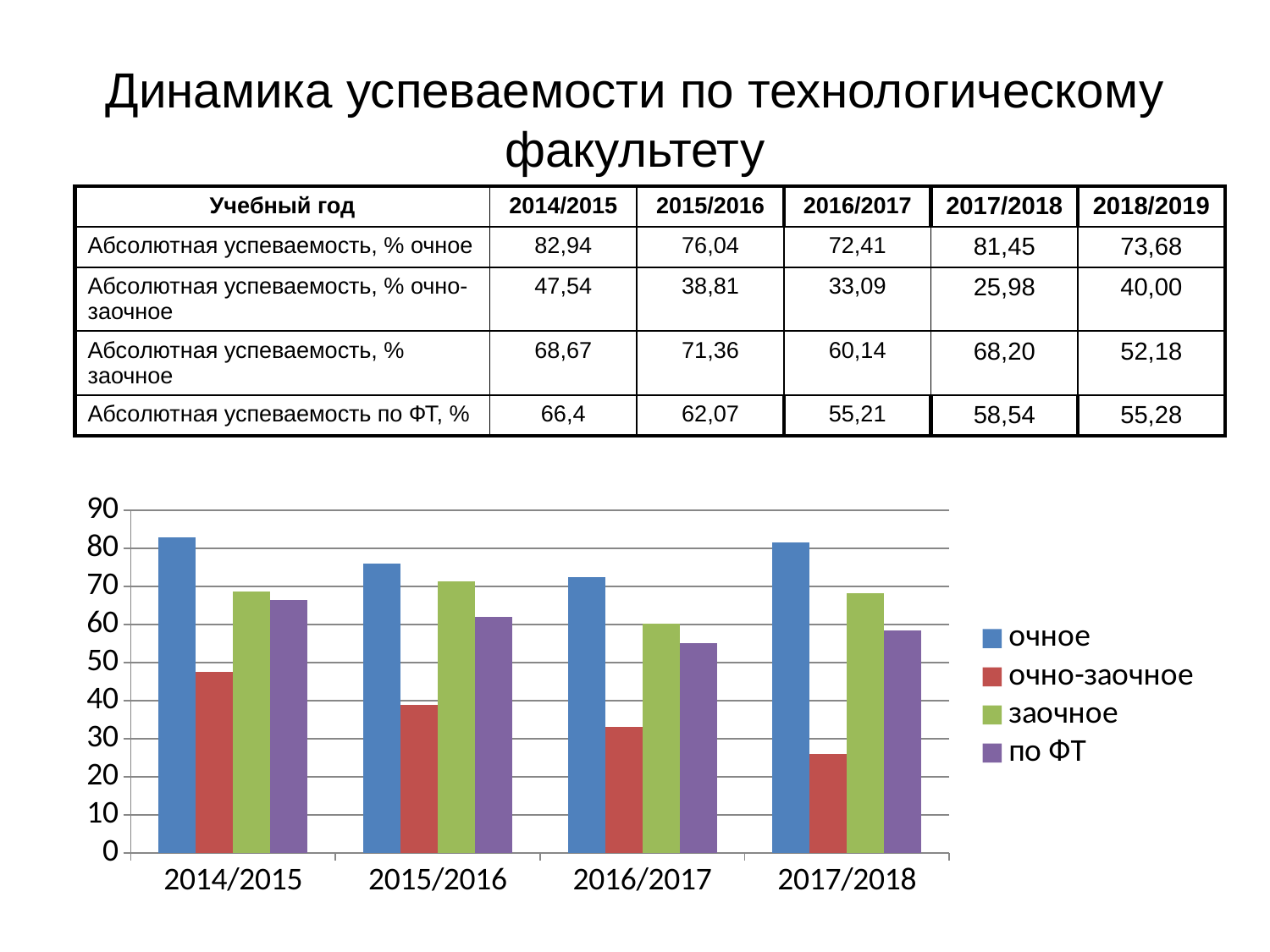
How many academic years are shown on the x axis of the chart? 4 How many series does the chart legend list? 4 According to the table, what is the difference between очное and очно-заочное in 2014/2015? 35,40 Is the value for очно-заочное in 2017/2018 greater or less than 30? less In 2015/2016, which is larger: заочное or по ФТ? заочное What colour represents the заочное series in the chart? green Which series has the highest bar for 2014/2015? очное What kind of chart is shown on the slide? bar chart Is the value for очное in 2014/2015 greater or less than 80? greater According to the table, what is the value for очное in 2016/2017? 72,41 Do the values for очно-заочное rise or fall from 2014/2015 to 2017/2018? fall Which series has the lowest bar for 2017/2018? очно-заочное